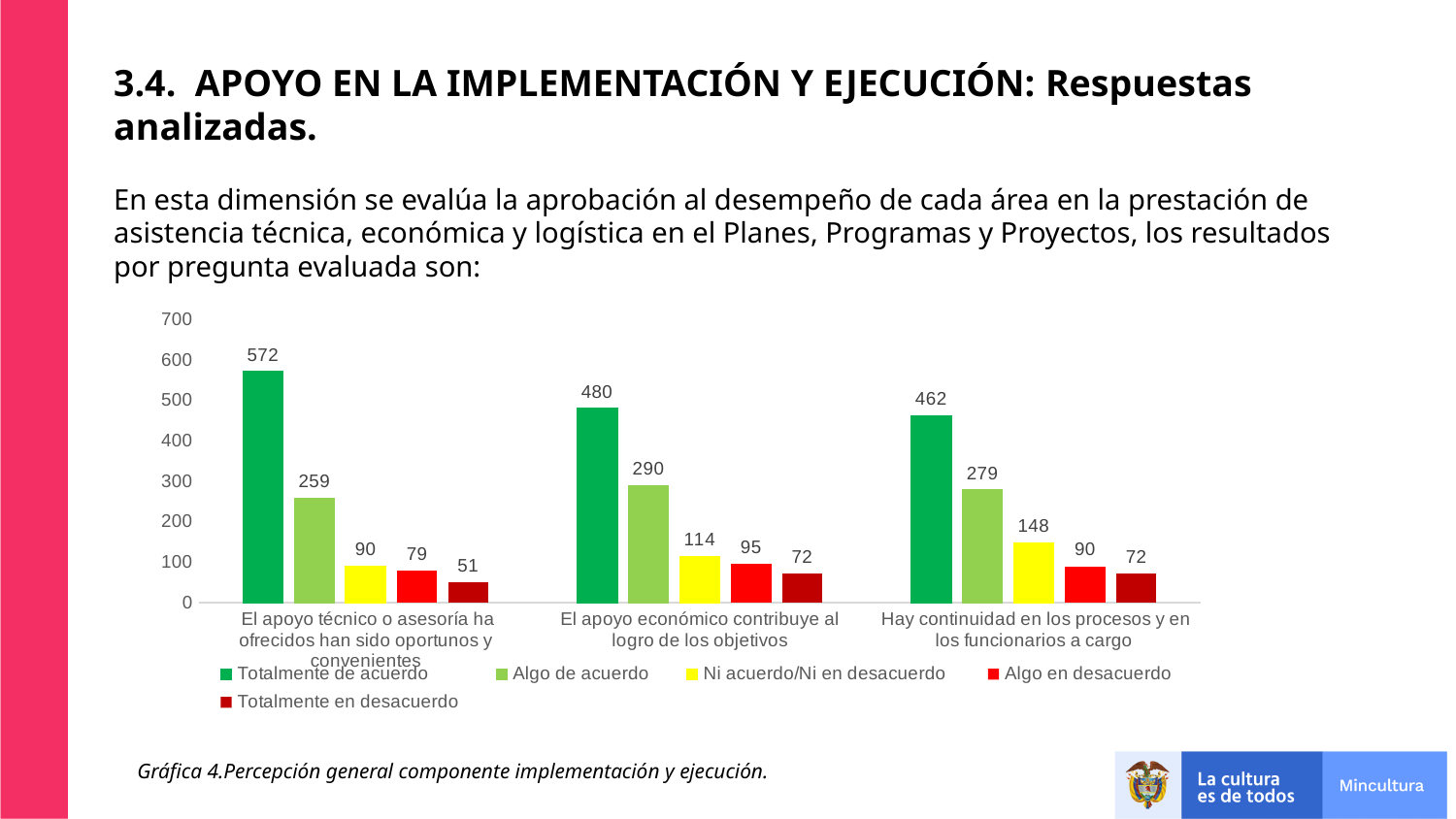
What is the value of "Totalmente de acuerdo" for "El apoyo económico contribuye al logro de los objetivos"? 480 What is the difference between the "Totalmente de acuerdo" values for "El apoyo técnico o asesoría ha ofrecidos han sido oportunos y convenientes" and "El apoyo económico contribuye al logro de los objetivos"? 92 What colour represents the "Ni acuerdo/Ni en desacuerdo" series? Yellow What is the value of "Ni acuerdo/Ni en desacuerdo" for "Hay continuidad en los procesos y en los funcionarios a cargo"? 148 How many categories (questions) are shown on the x axis? 3 Which category has the highest "Totalmente de acuerdo" value? El apoyo técnico o asesoría ha ofrecidos han sido oportunos y convenientes Which is larger: "Algo en desacuerdo" for "El apoyo económico contribuye al logro de los objetivos" or "Algo en desacuerdo" for "Hay continuidad en los procesos y en los funcionarios a cargo"? El apoyo económico contribuye al logro de los objetivos Is the "Totalmente de acuerdo" value for "Hay continuidad en los procesos y en los funcionarios a cargo" greater or less than 500? less How many series does the legend list? 5 Which category has the lowest "Algo de acuerdo" value? El apoyo técnico o asesoría ha ofrecidos han sido oportunos y convenientes What type of chart is shown on the slide? Bar chart What is the value of "Totalmente en desacuerdo" for "El apoyo técnico o asesoría ha ofrecidos han sido oportunos y convenientes"? 51